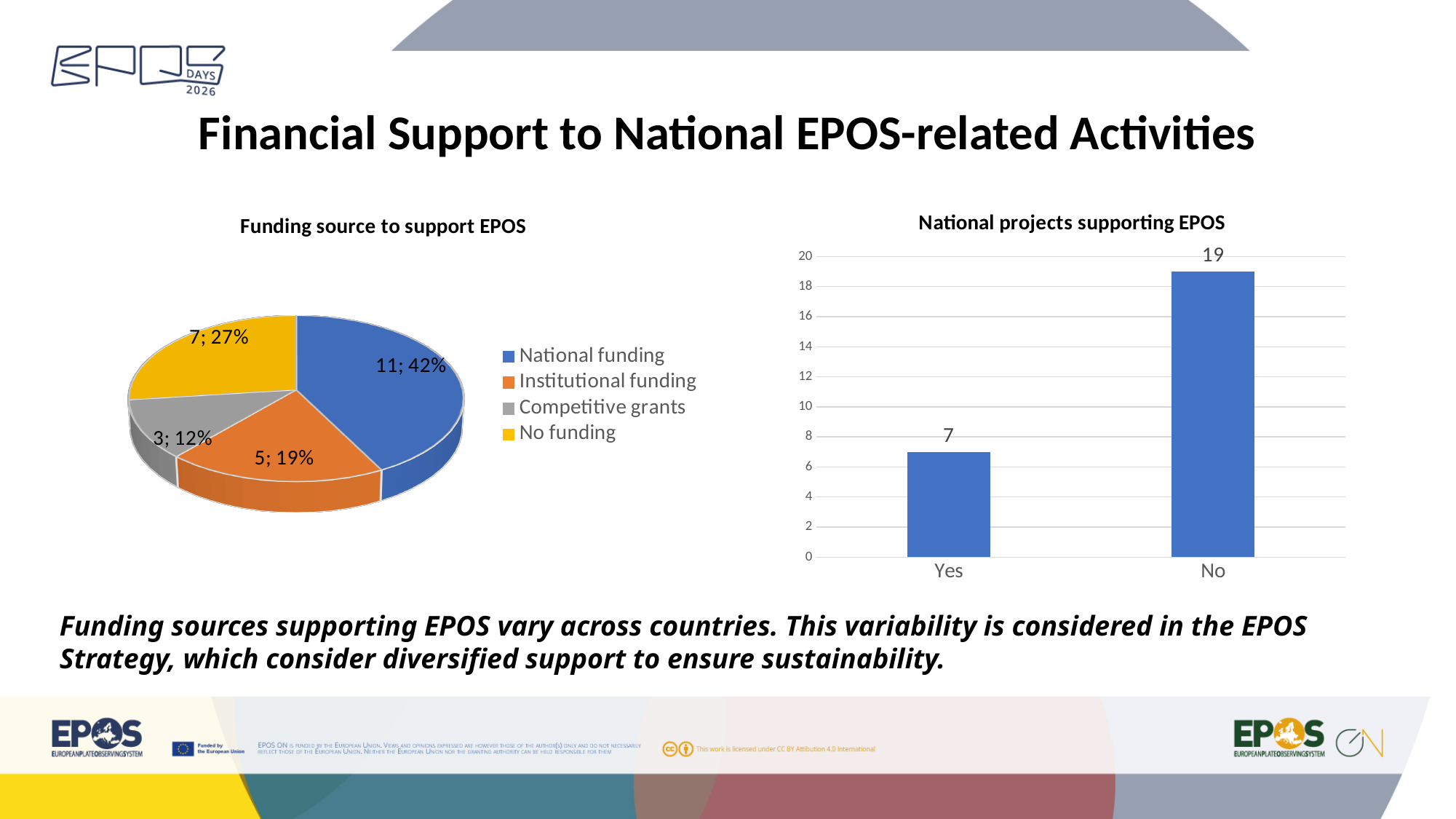
In the 'Funding source to support EPOS' chart, what share of the pie is Competitive grants? 12% In the 'National projects supporting EPOS' chart, what is the value for No? 19 In the 'National projects supporting EPOS' chart, what is the value for Yes? 7 In the 'Funding source to support EPOS' chart, which funding source has the smallest slice? Competitive grants In the 'Funding source to support EPOS' chart, which funding source has the largest slice? National funding In the 'Funding source to support EPOS' chart, what is the difference between the counts for No funding and Institutional funding? 2 In the 'Funding source to support EPOS' chart, what kind of chart is used? Pie chart In the 'Funding source to support EPOS' chart, what value is shown for National funding? 11; 42% In the 'Funding source to support EPOS' chart, how many categories does the legend list? 4 In the 'National projects supporting EPOS' chart, what is the difference between No and Yes? 12 In the 'National projects supporting EPOS' chart, what kind of chart is used? Bar chart In the 'Funding source to support EPOS' chart, what colour is the No funding slice? Yellow